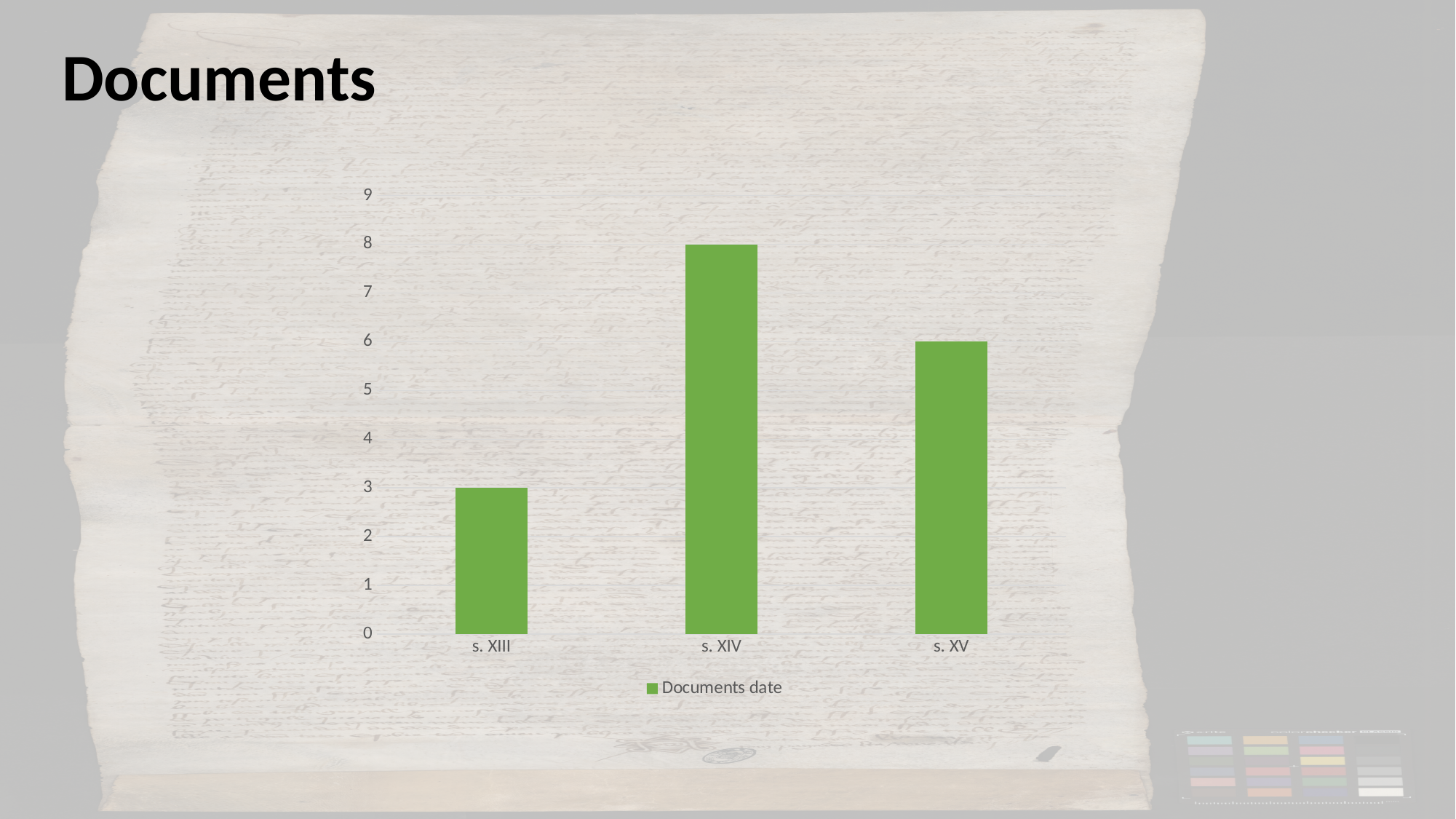
What kind of chart is shown on the slide? bar chart Which is larger, the value for s. XV or the value for s. XIII? s. XV What is the value for s. XV? 6 Which category has the highest value? s. XIV What is the name of the series shown in the chart legend? Documents date Which category has the lowest value? s. XIII How many series does the chart legend list? 1 What is the value for s. XIV? 8 Is the value for s. XIV greater or less than 5? greater What is the difference between the values for s. XIV and s. XV? 2 How many categories are shown on the x axis of the chart? 3 What is the value for s. XIII? 3